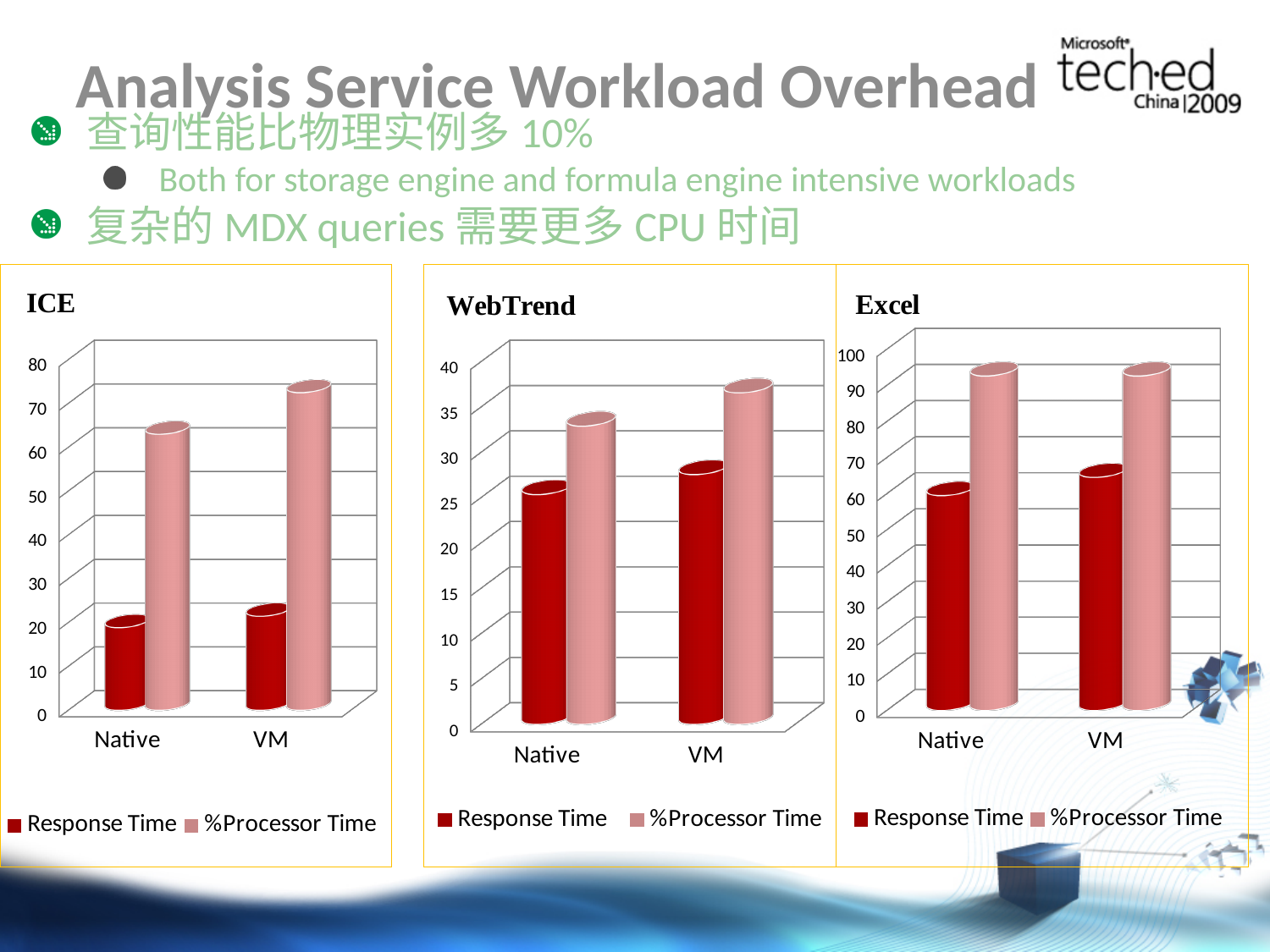
In the WebTrend chart, is the %Processor Time value for VM greater or less than 35? greater In the ICE chart, which category has the larger %Processor Time, Native or VM? VM In the ICE chart, is the %Processor Time value for VM greater or less than 70? greater In the WebTrend chart, which category has the larger %Processor Time, Native or VM? VM In the Excel chart, is the %Processor Time value for Native greater or less than 90? greater How many categories are shown on the x axis of the Excel chart? 2 In the Excel chart, which series has the higher values, Response Time or %Processor Time? %Processor Time What type of chart is the ICE chart? bar chart How many series does the legend of the WebTrend chart list? 2